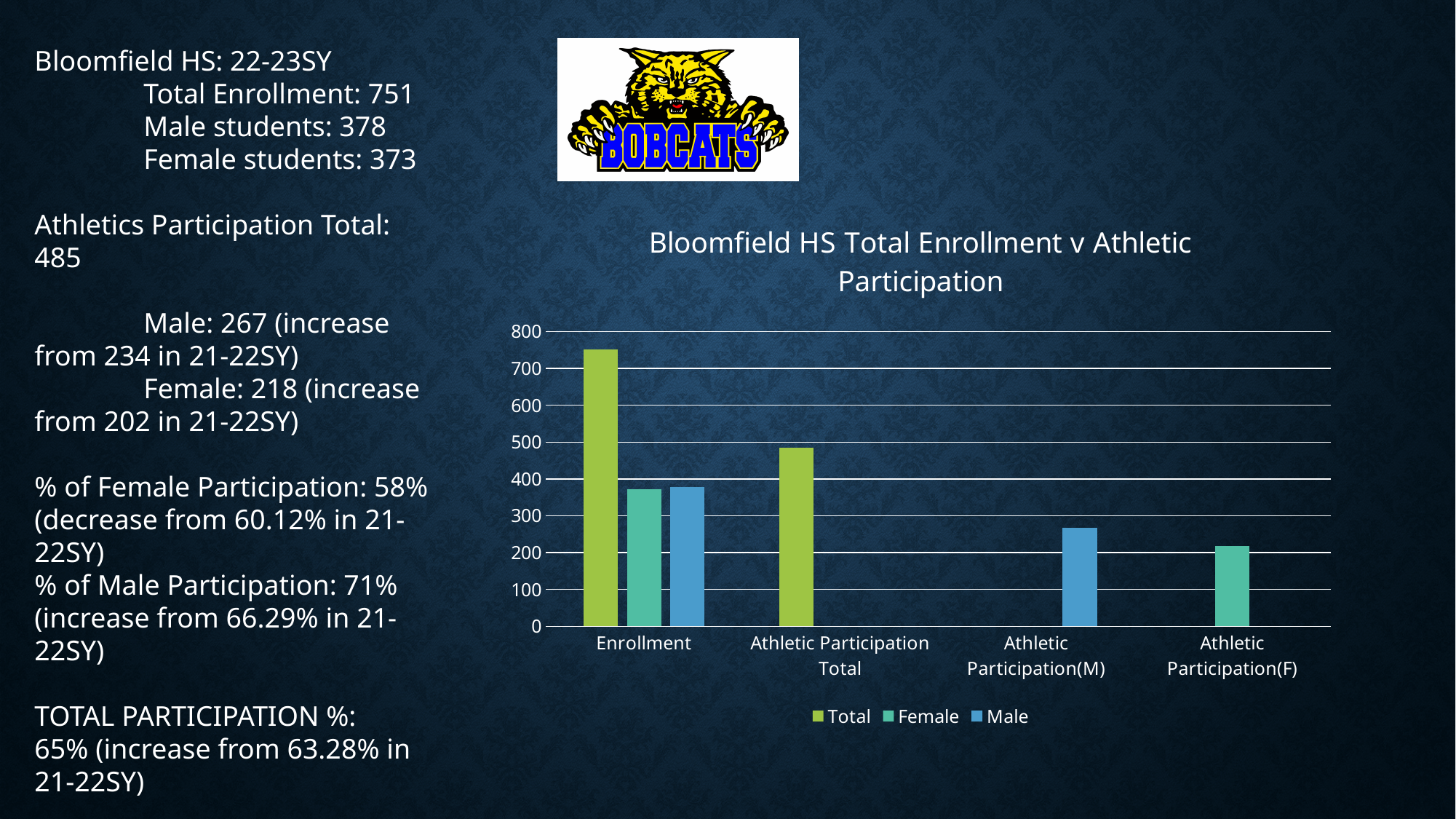
What is the title of the chart? Bloomfield HS Total Enrollment v Athletic Participation Is the Female value for Athletic Participation(F) greater or less than 300? less Which category has the shortest bar in the chart? Athletic Participation(F) Is the Total value for Enrollment greater or less than 700? greater How many series does the chart legend list? 3 What type of chart is shown on the slide? bar chart Is the Male value for Athletic Participation(M) greater or less than 300? less How many categories are shown on the x axis of the chart? 4 Which is larger: the Male bar for Athletic Participation(M) or the Female bar for Athletic Participation(F)? Athletic Participation(M) Which colour represents the Total series in the chart legend? green Which category has the tallest bar in the chart? Enrollment